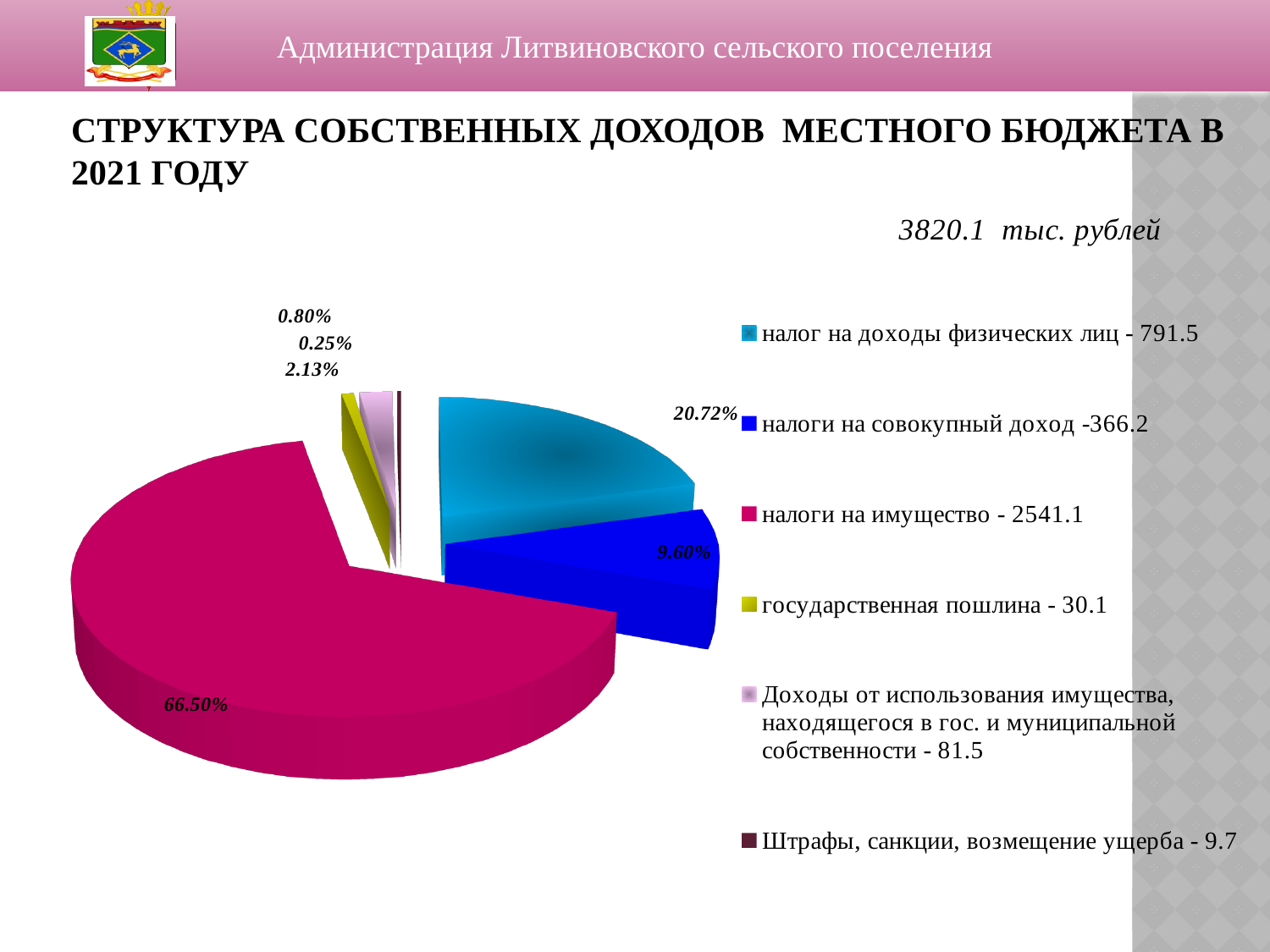
What value is given in the legend for государственная пошлина? 30.1 What percentage is shown for налоги на совокупный доход? 9.60% What percentage is shown for налог на доходы физических лиц? 20.72% What share of the pie is labelled for налоги на имущество? 66.50% Which is larger: налог на доходы физических лиц or налоги на совокупный доход? налог на доходы физических лиц What total amount in thousand rubles is shown above the chart? 3820.1 тыс. рублей Which category has the smallest value according to the legend? Штрафы, санкции, возмещение ущерба How many categories does the legend list? 6 What kind of chart is shown on the slide? pie chart What value is given in the legend for налоги на имущество? 2541.1 Which category has the largest slice of the pie? налоги на имущество What is the difference between the legend values for налог на доходы физических лиц (791.5) and налоги на совокупный доход (366.2)? 425.3